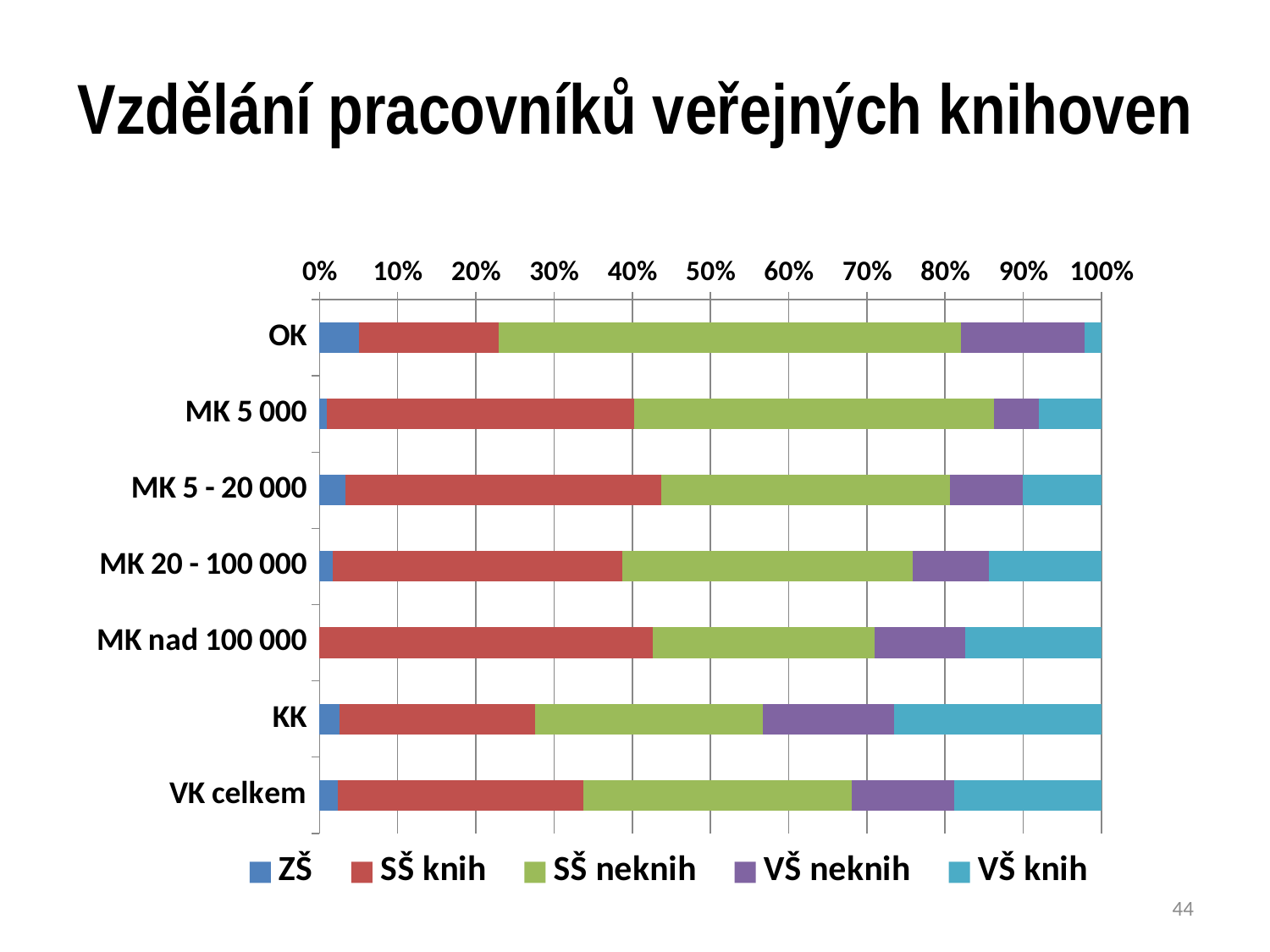
Which category has the largest VŠ knih segment? KK Which series is shown in green in the legend? SŠ neknih What kind of chart is shown on the slide? Bar chart How many series does the legend list? 5 Which category has the largest SŠ neknih segment? OK Is the VŠ knih share for KK greater or less than 20%? greater What is the total of the stacked bar for VK celkem? 100% How many categories (library types) are shown on the y axis? 7 What is the title of the chart? Vzdělání pracovníků veřejných knihoven Is the SŠ neknih share for OK greater or less than 50%? greater Which has a larger VŠ knih share, KK or MK nad 100 000? KK Which category has the smallest VŠ knih segment? OK